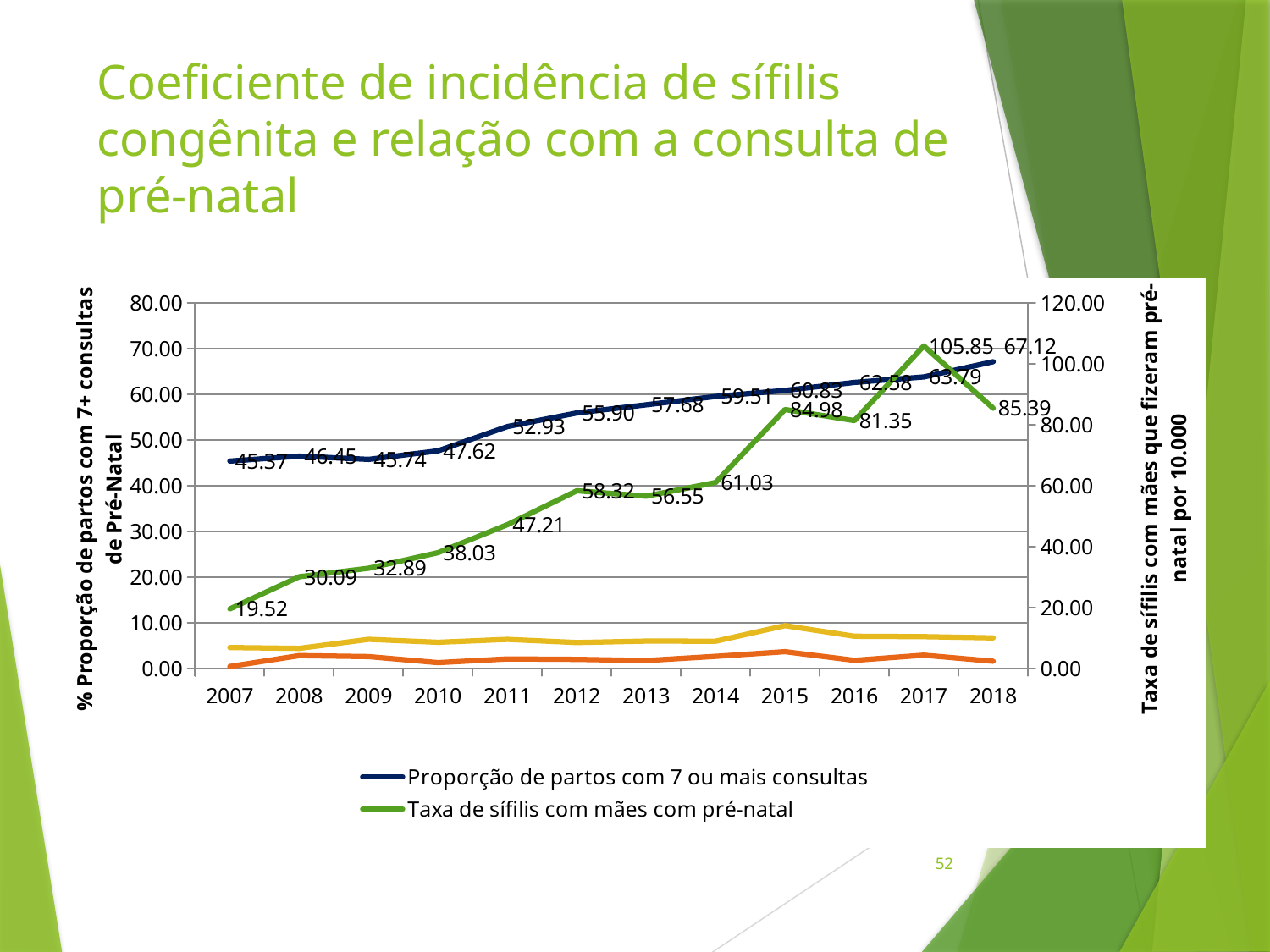
What type of chart is shown on the slide? line chart Which is larger for 'Taxa de sífilis com mães com pré-natal': the value in 2015 or in 2016? 2015 What is the difference between the 'Taxa de sífilis com mães com pré-natal' values in 2017 and 2018? 20.46 What is the value of 'Taxa de sífilis com mães com pré-natal' in 2007? 19.52 How many years are shown on the x axis? 12 In which year is 'Proporção de partos com 7 ou mais consultas' lowest? 2007 What is the value of 'Proporção de partos com 7 ou mais consultas' in 2018? 67.12 In which year does 'Taxa de sífilis com mães com pré-natal' reach its highest value? 2017 What is the title of the chart on the slide? Coeficiente de incidência de sífilis congênita e relação com a consulta de pré-natal Does 'Proporção de partos com 7 ou mais consultas' generally rise or fall from 2007 to 2018? rise What is the value of 'Taxa de sífilis com mães com pré-natal' in 2011? 47.21 How many series does the legend list? 2